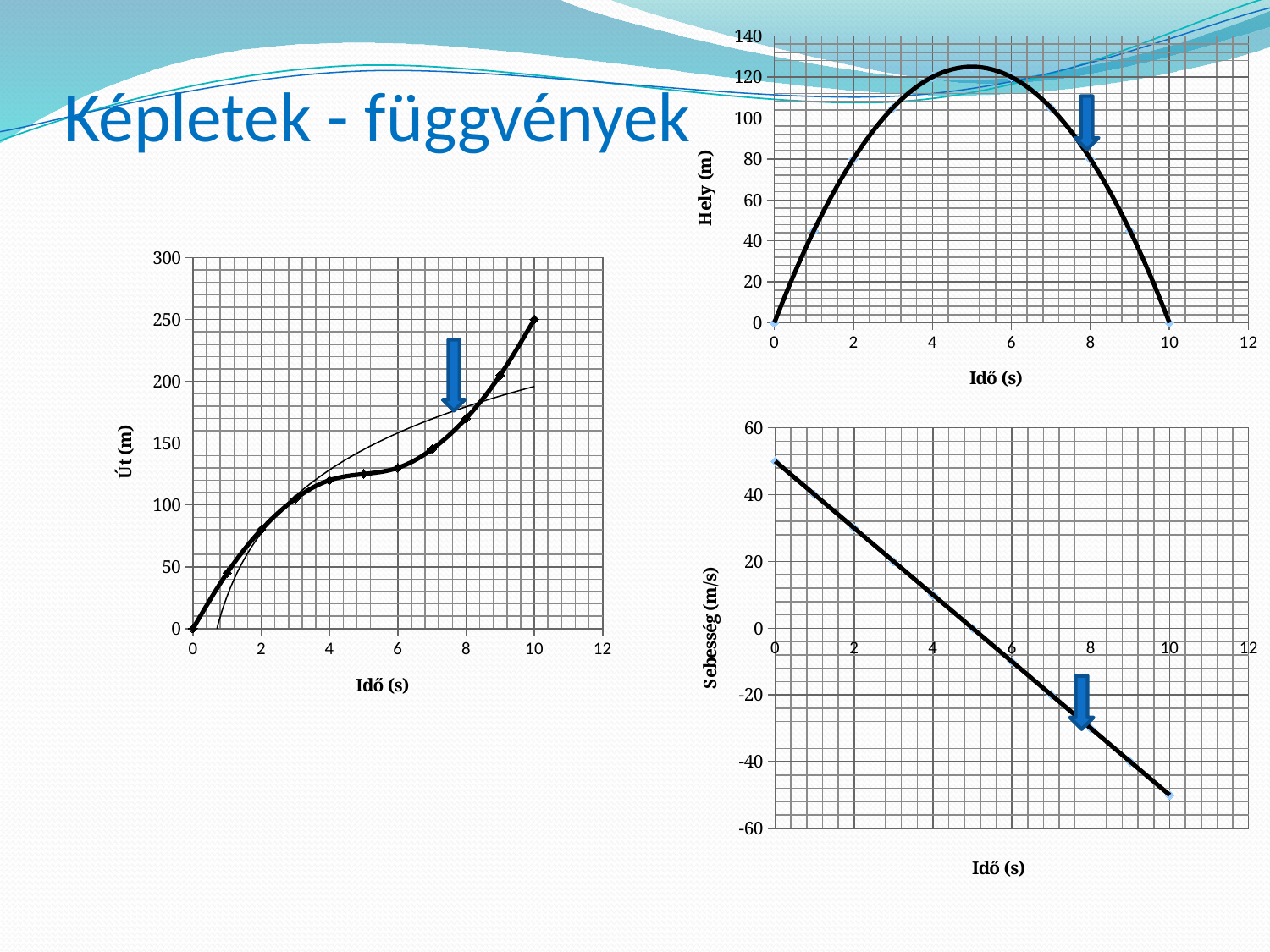
In the left chart (Út vs Idő), do the values rise or fall as Idő increases? rise What kind of chart is the chart on the left of the slide (Út vs Idő)? line chart In the bottom-right chart (Sebesség vs Idő), is the value at Idő = 8 s greater or less than -20? less In the bottom-right chart (Sebesség vs Idő), what is the value of Sebesség at Idő = 5 s? 0 In the left chart (Út vs Idő), what is the value of Út at Idő = 10 s? 250 In the left chart (Út vs Idő), is the value at Idő = 4 s greater or less than 100? greater In the top-right chart (Hely vs Idő), what is the value of Hely at Idő = 10 s? 0 In the bottom-right chart (Sebesség vs Idő), do the values rise or fall as Idő increases? fall In the left chart (Út vs Idő), what is the value of Út at Idő = 0 s? 0 What is the label of the vertical axis of the top-right chart? Hely (m) In the top-right chart (Hely vs Idő), is the value at Idő = 2 s greater or less than 60? greater